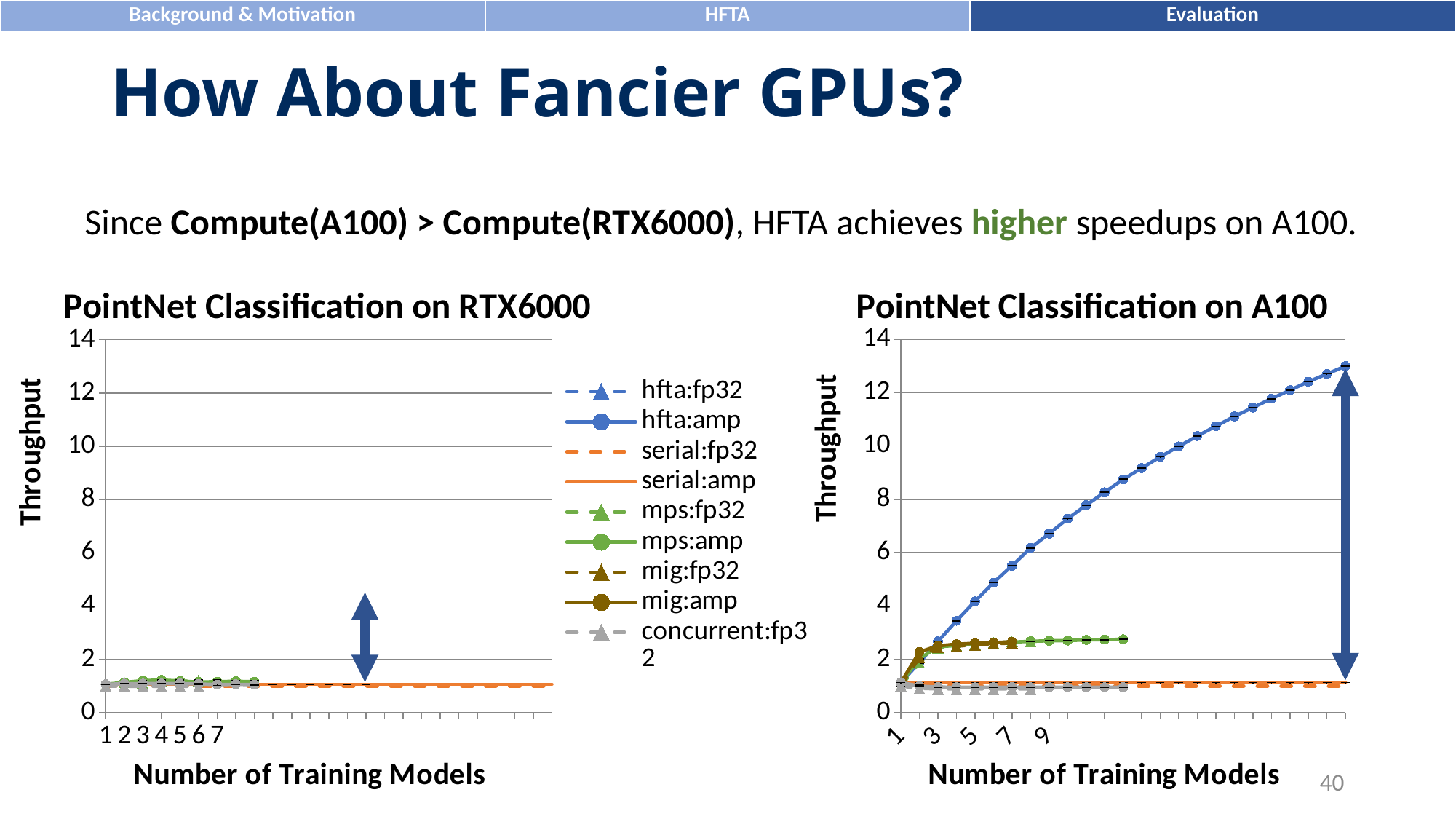
In the PointNet Classification on A100 chart, which series reaches the highest throughput? hfta:amp In the PointNet Classification on A100 chart, is the last plotted value of mps:amp greater or less than 4? less In the PointNet Classification on A100 chart, at the rightmost point, which is larger: hfta:amp or serial:amp? hfta:amp In the PointNet Classification on A100 chart, is the last plotted value of mps:amp greater or less than 2? greater In the PointNet Classification on A100 chart, does the throughput of hfta:amp rise or fall as the number of training models increases? rise What is the x-axis title of the PointNet Classification on A100 chart? Number of Training Models What kind of chart is the PointNet Classification on A100 chart? line chart What is the y-axis title of the PointNet Classification on RTX6000 chart? Throughput How many series does the legend list for the charts? 9 In the PointNet Classification on A100 chart, is the highest value of hfta:amp greater or less than 12? greater